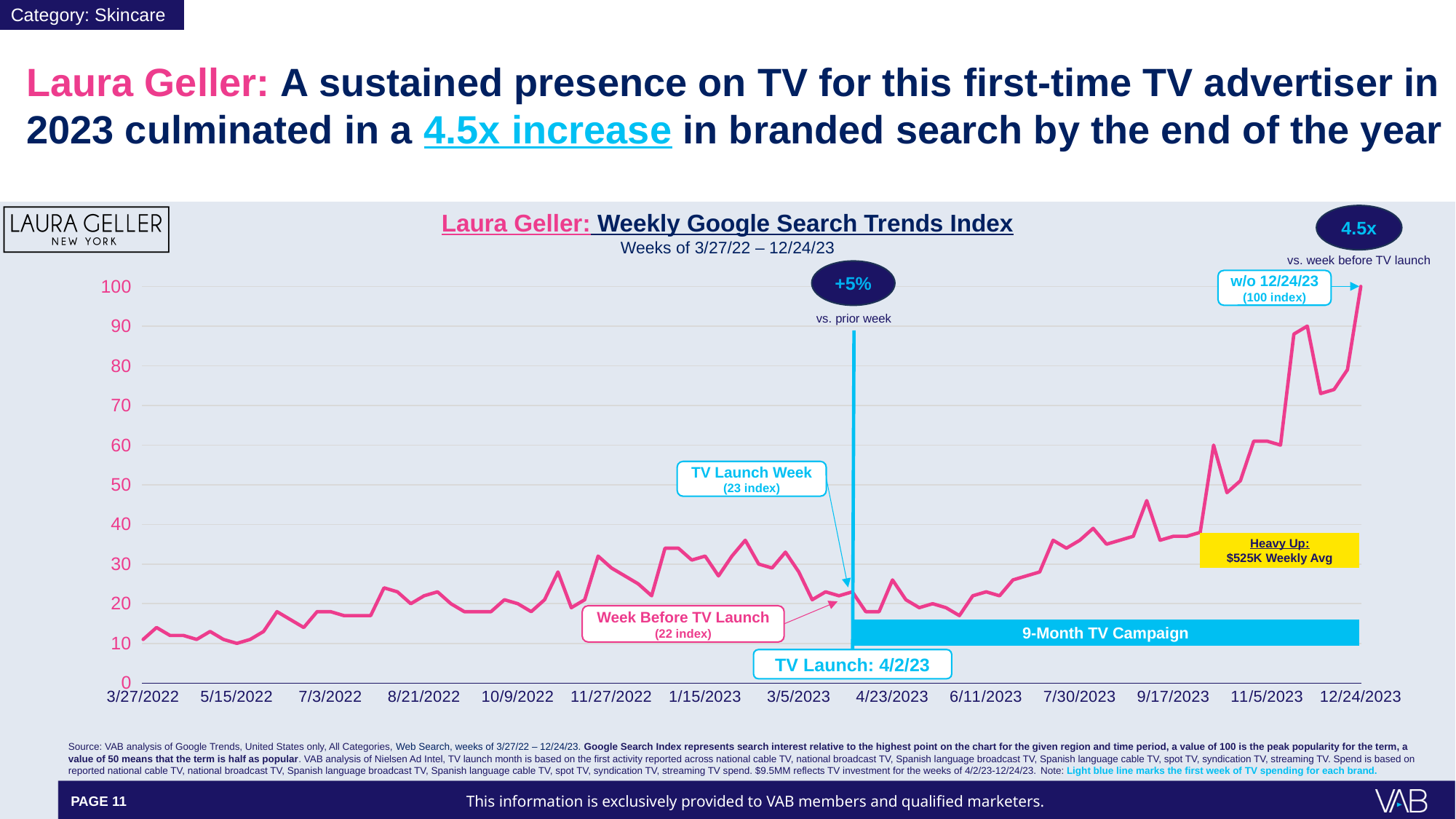
What was the index value in the week before the TV launch? 22 What was the percentage change in the index in the TV launch week vs. the prior week? +5% What was the Google Search Trends Index value in the TV Launch Week? 23 Which week has the highest index value on the chart? w/o 12/24/23 By what multiple did the index at the end of the year exceed the week before TV launch, according to the chart annotation? 4.5x On what date did the TV launch occur, according to the chart? 4/2/23 What was the index value for the week of 12/24/23? 100 Is the index value at 3/27/2022 greater or less than 20? less Does the index rise or fall between 9/17/2023 and 12/24/2023? rise Is the index value at 9/17/2023 greater or less than 50? less By how much did the index increase from the week before TV launch to the week of 12/24/23? 78 What kind of chart is shown on the slide? Line chart